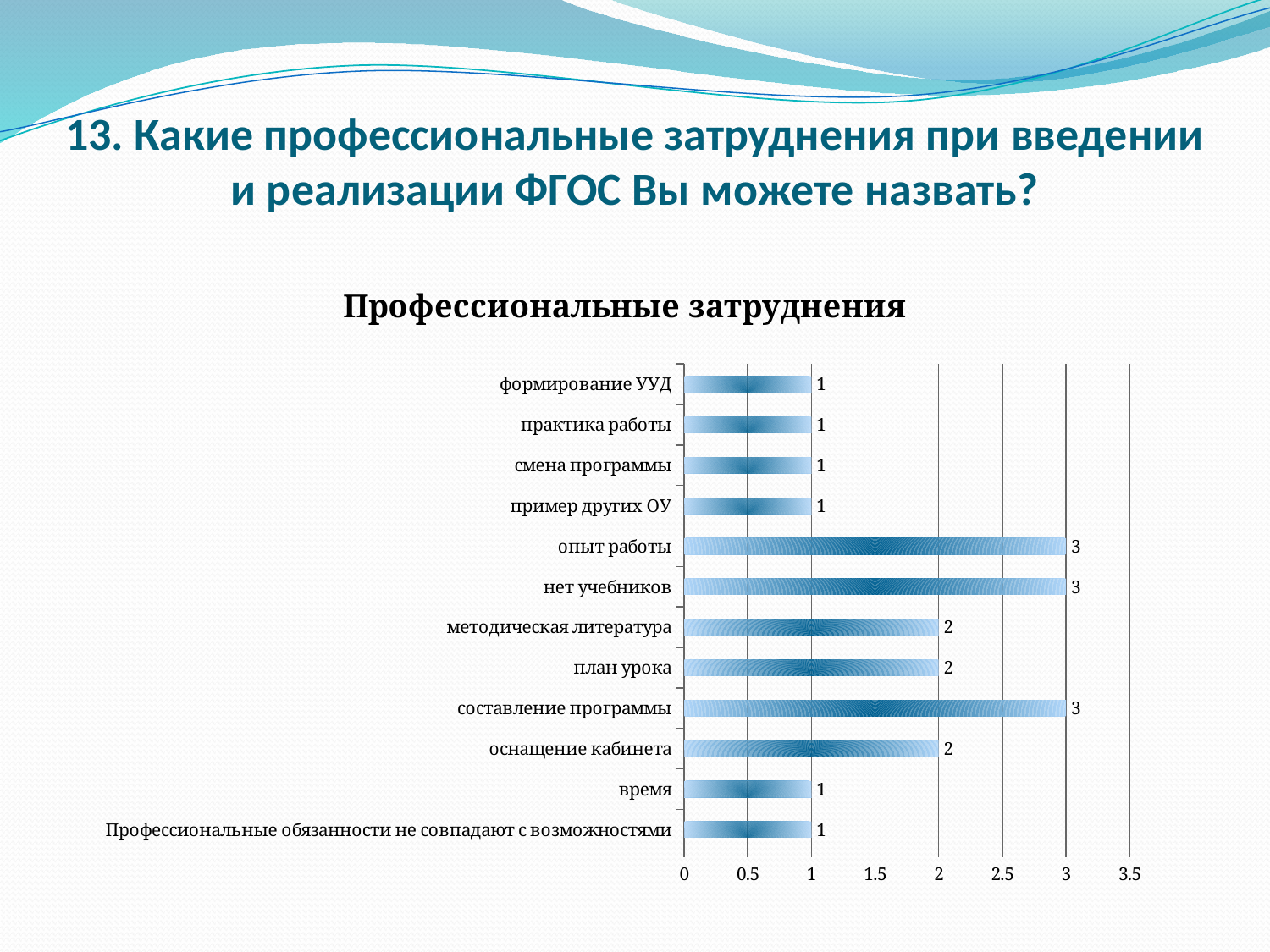
What is the highest value shown in the chart? 3 How many categories are shown in the chart? 12 What is the title of the chart? Профессиональные затруднения What is the value for "оснащение кабинета"? 2 What kind of chart is shown on the slide? bar chart What is the value for "время"? 1 What is the value for "опыт работы"? 3 What is the difference between the values for "опыт работы" and "формирование УУД"? 2 What is the value for "план урока"? 2 What is the difference between the values for "составление программы" and "план урока"? 1 Which is larger, the value for "нет учебников" or the value for "методическая литература"? нет учебников Is the value for "опыт работы" greater or less than 2.5? greater